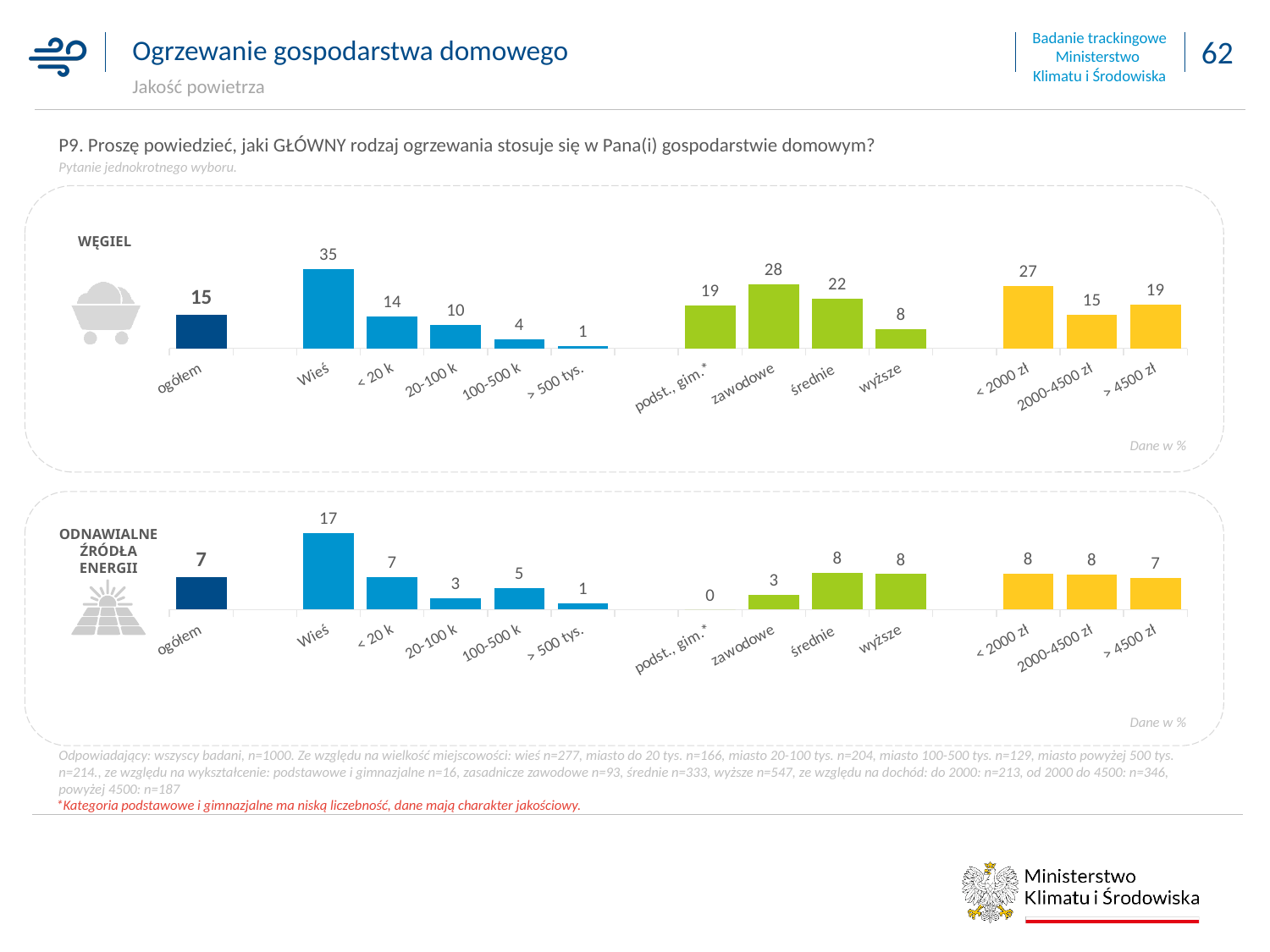
What kind of chart is the ODNAWIALNE ŹRÓDŁA ENERGII chart? Bar chart In the WĘGIEL chart, what is the value for Wieś? 35 In the ODNAWIALNE ŹRÓDŁA ENERGII chart, what is the value for ogółem? 7 In the WĘGIEL chart, what is the difference between the values for zawodowe and wyższe? 20 In the WĘGIEL chart, what is the value for ogółem? 15 In the ODNAWIALNE ŹRÓDŁA ENERGII chart, which category has the highest value? Wieś In the WĘGIEL chart, which category has the lowest value? > 500 tys. In the WĘGIEL chart, which is larger: the value for < 2000 zł or the value for > 4500 zł? < 2000 zł In the ODNAWIALNE ŹRÓDŁA ENERGII chart, what is the difference between the values for Wieś and < 20 k? 10 In the ODNAWIALNE ŹRÓDŁA ENERGII chart, what is the value for podst., gim.*? 0 How many categories are plotted in the WĘGIEL chart? 13 In the WĘGIEL chart, which category has the highest value? Wieś